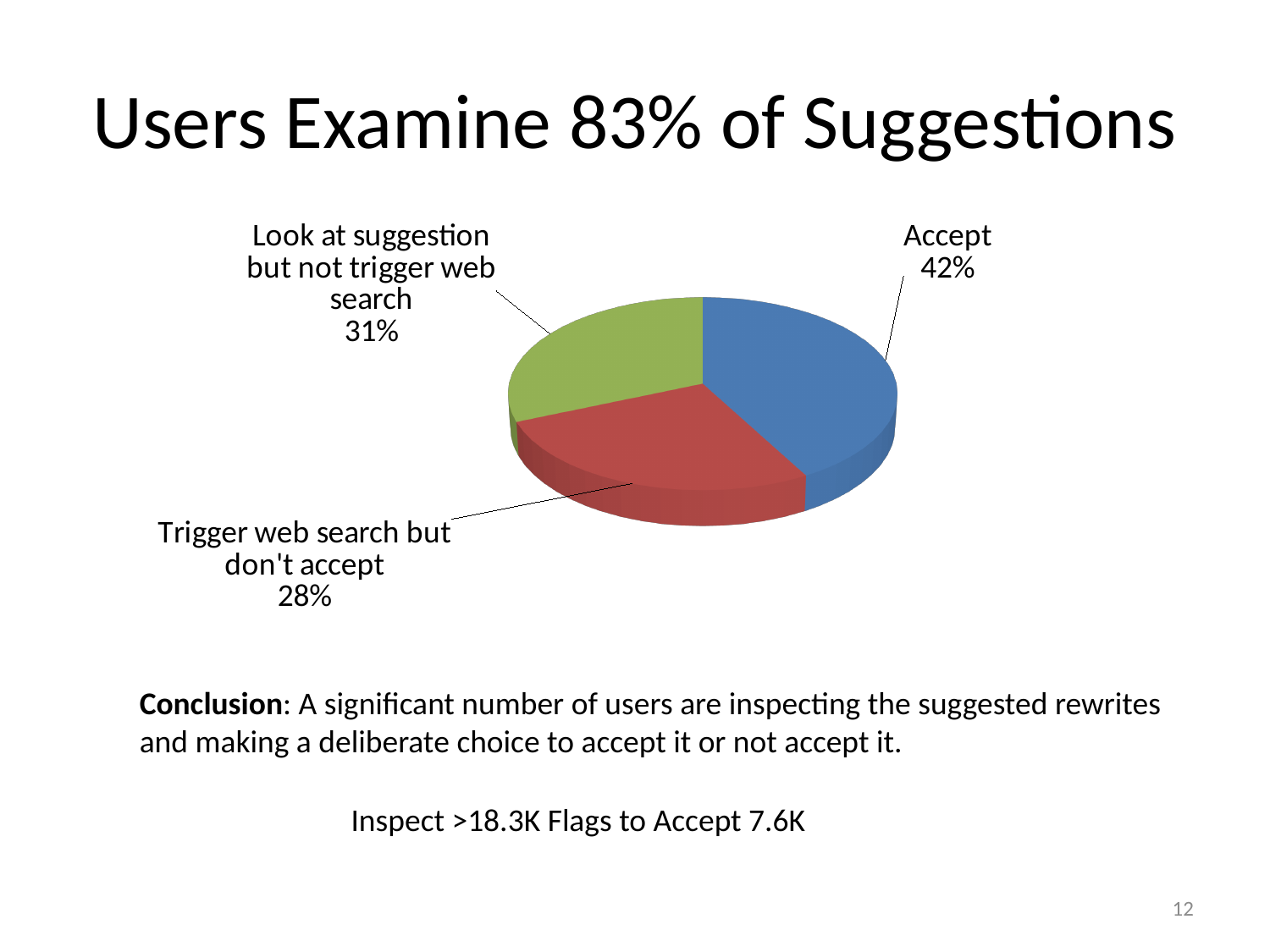
Which category has the largest share of the pie? Accept What kind of chart is shown on the slide? Pie chart Which category has the smallest share of the pie? Trigger web search but don't accept How many slices does the pie chart have? 3 What colour is the Accept slice of the pie? Blue What is the title of the slide containing the pie chart? Users Examine 83% of Suggestions What percentage of users trigger a web search but don't accept? 28% What percentage of users Accept the suggestion? 42% What is the difference in percentage points between Look at suggestion but not trigger web search and Trigger web search but don't accept? 3 What percentage of users look at the suggestion but do not trigger a web search? 31% What is the difference in percentage points between Accept and Trigger web search but don't accept? 14 Which is larger: the share for Accept or the share for Look at suggestion but not trigger web search? Accept